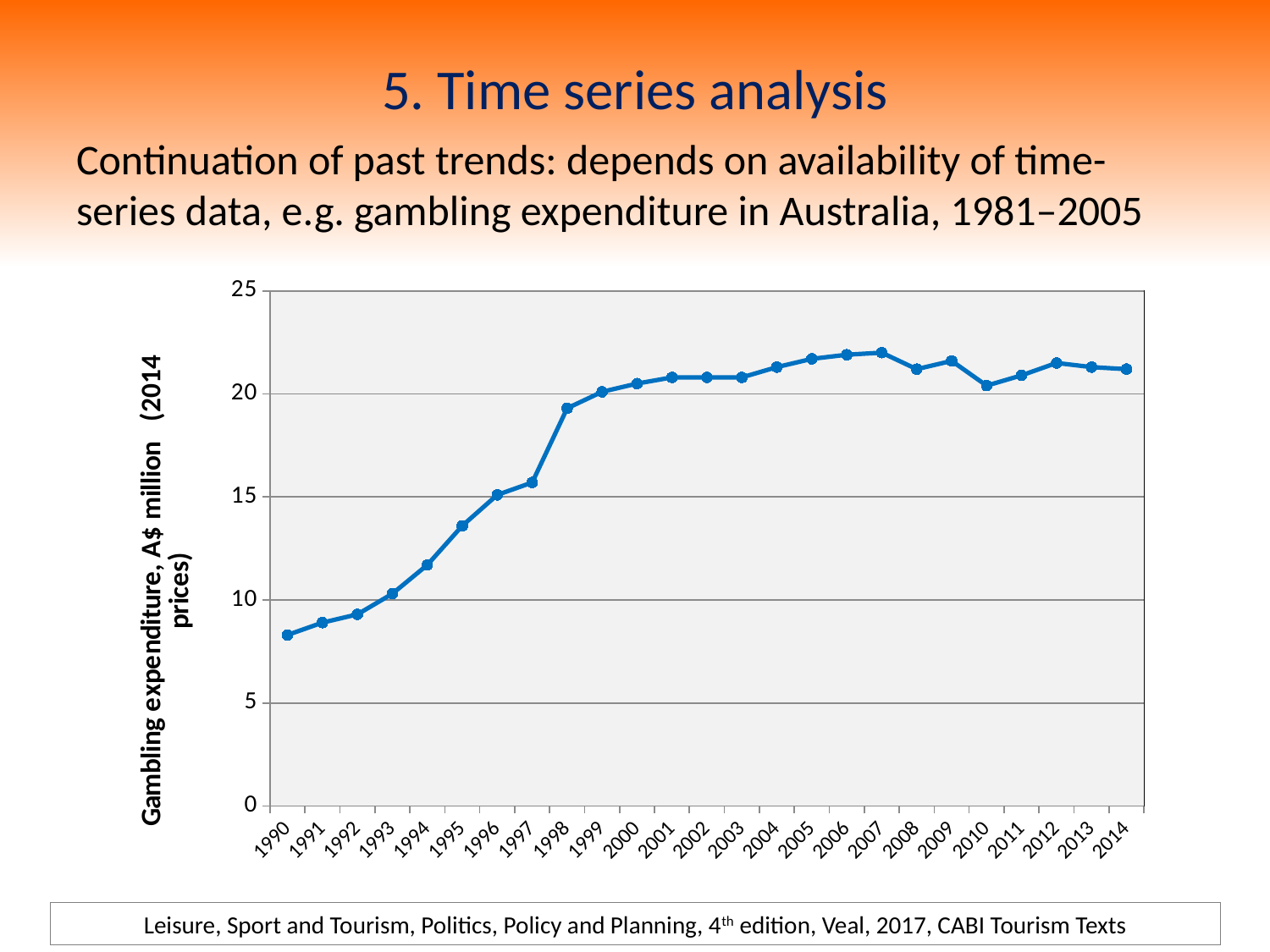
Which year has the lowest gambling expenditure on the chart? 1990 What is the label on the vertical axis of the chart? Gambling expenditure, A$ million (2014 prices) Is the value for 1990 greater or less than 10? less Which year has the larger value, 1993 or 2010? 2010 Is the value for 1995 greater or less than 15? less How many years (data points) are plotted on the chart? 25 What kind of chart is shown on the slide? Line chart Which year has the larger value, 1997 or 1998? 1998 Overall, do the values rise or fall from 1990 to 2014? Rise Is the value for 1998 greater or less than 20? less